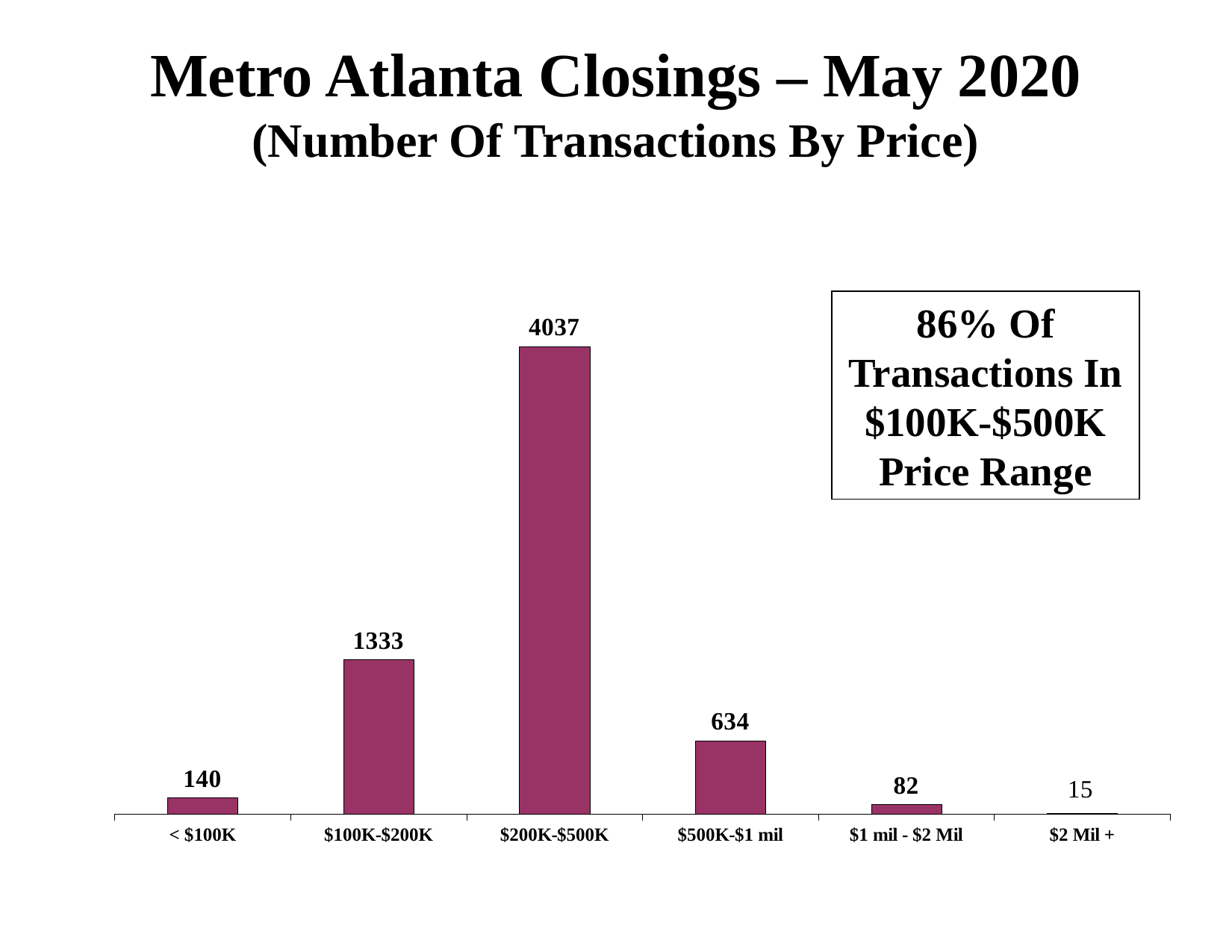
How many price range categories are shown on the chart? 6 What is the number of transactions for the < $100K category? 140 Which has more transactions, $100K-$200K or $500K-$1 mil? $100K-$200K Which price range has the lowest number of transactions? $2 Mil + What type of chart is shown on the slide? Bar chart What is the title of the chart on the slide? Metro Atlanta Closings – May 2020 (Number Of Transactions By Price) Which price range has the highest number of transactions? $200K-$500K According to the text box on the slide, what percentage of transactions were in the $100K-$500K price range? 86% How many transactions were in the $200K-$500K price range? 4037 What is the difference between the $500K-$1 mil value and the < $100K value? 494 What value is shown for the $1 mil - $2 Mil category? 82 What is the difference between the number of transactions in the $200K-$500K range and the $100K-$200K range? 2704